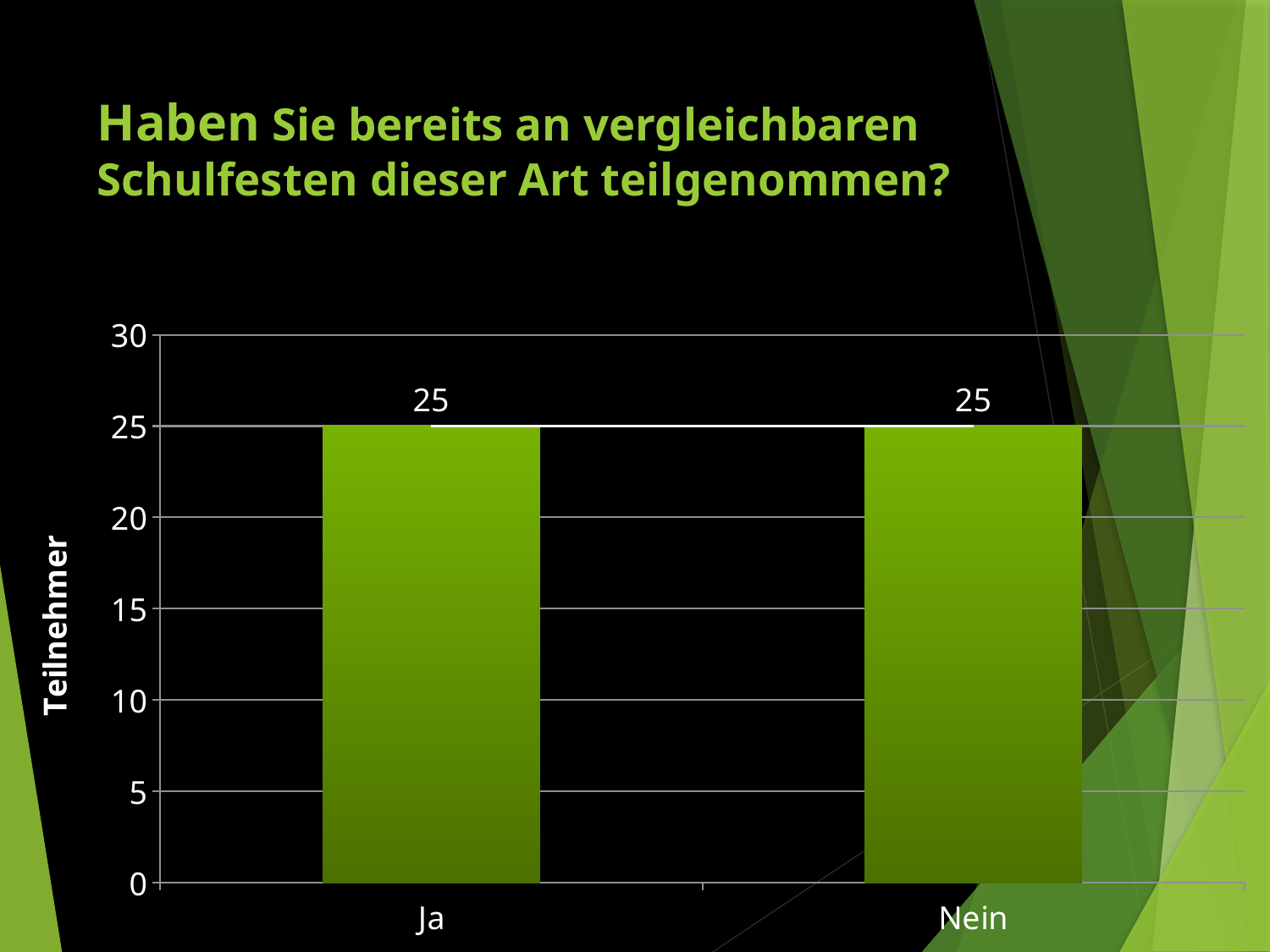
What is the label of the vertical axis? Teilnehmer What is the highest value shown on the vertical axis? 30 What is the difference between the values for Ja and Nein? 0 Is the value for Ja greater or less than 20? greater What is the value for Nein? 25 Do the values for Ja and Nein differ, or are they equal? equal What is the value for Ja? 25 What is the total of the values for Ja and Nein? 50 How many categories are shown on the x axis? 2 Is the value for Nein greater or less than 30? less What kind of chart is shown on the slide? bar chart